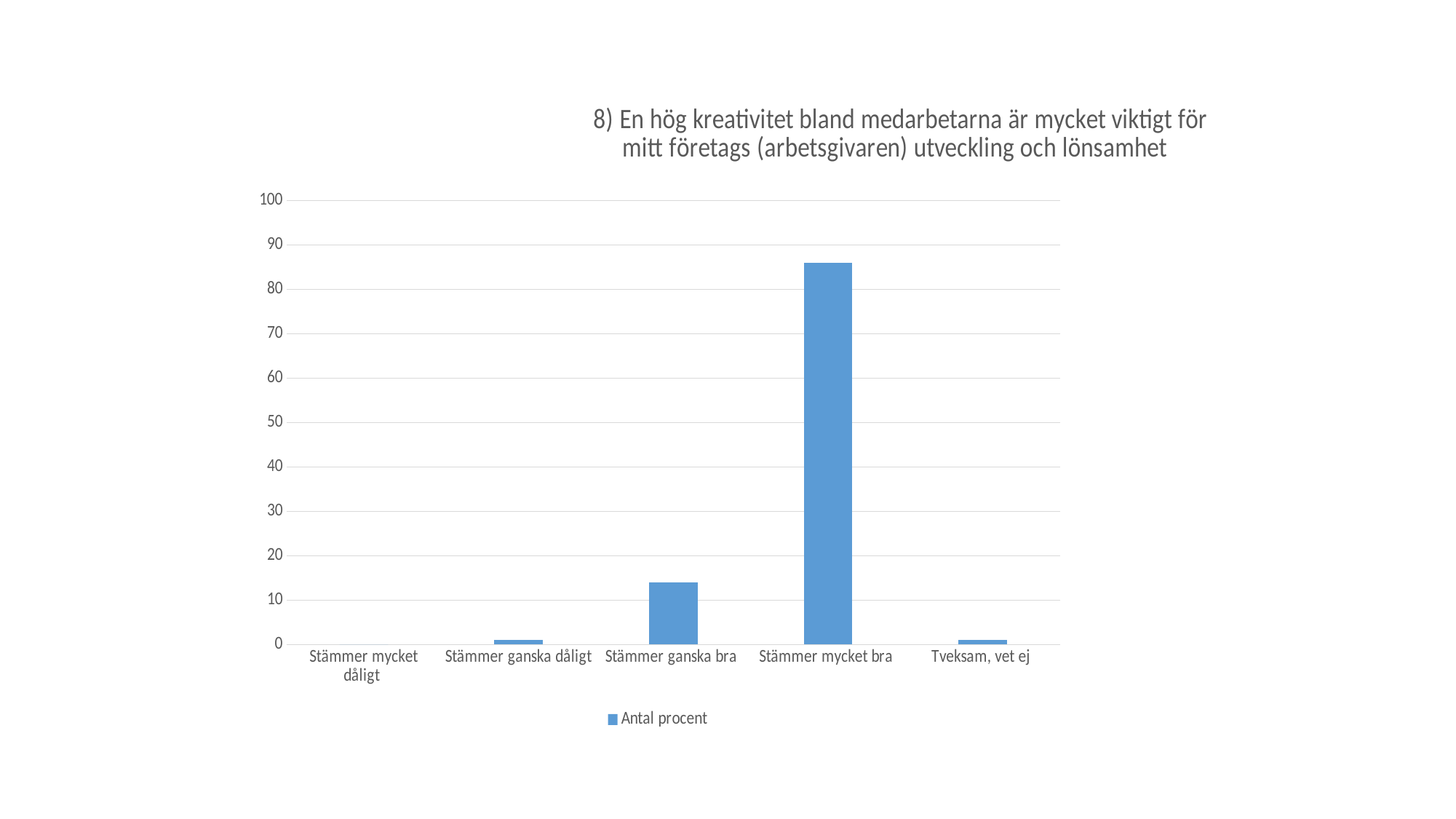
Is the value for Stämmer ganska dåligt greater or less than 10? less Is the value for Stämmer ganska bra greater or less than 10? greater Is the value for Stämmer ganska bra greater or less than 20? less Which is larger, the value for Stämmer mycket bra or the value for Stämmer ganska bra? Stämmer mycket bra Which is larger, the value for Stämmer ganska bra or the value for Tveksam, vet ej? Stämmer ganska bra Which category has the highest value? Stämmer mycket bra How many series does the legend list? 1 How many categories are shown on the x axis? 5 What kind of chart is shown on the slide? bar chart What is the name of the series shown in the legend? Antal procent